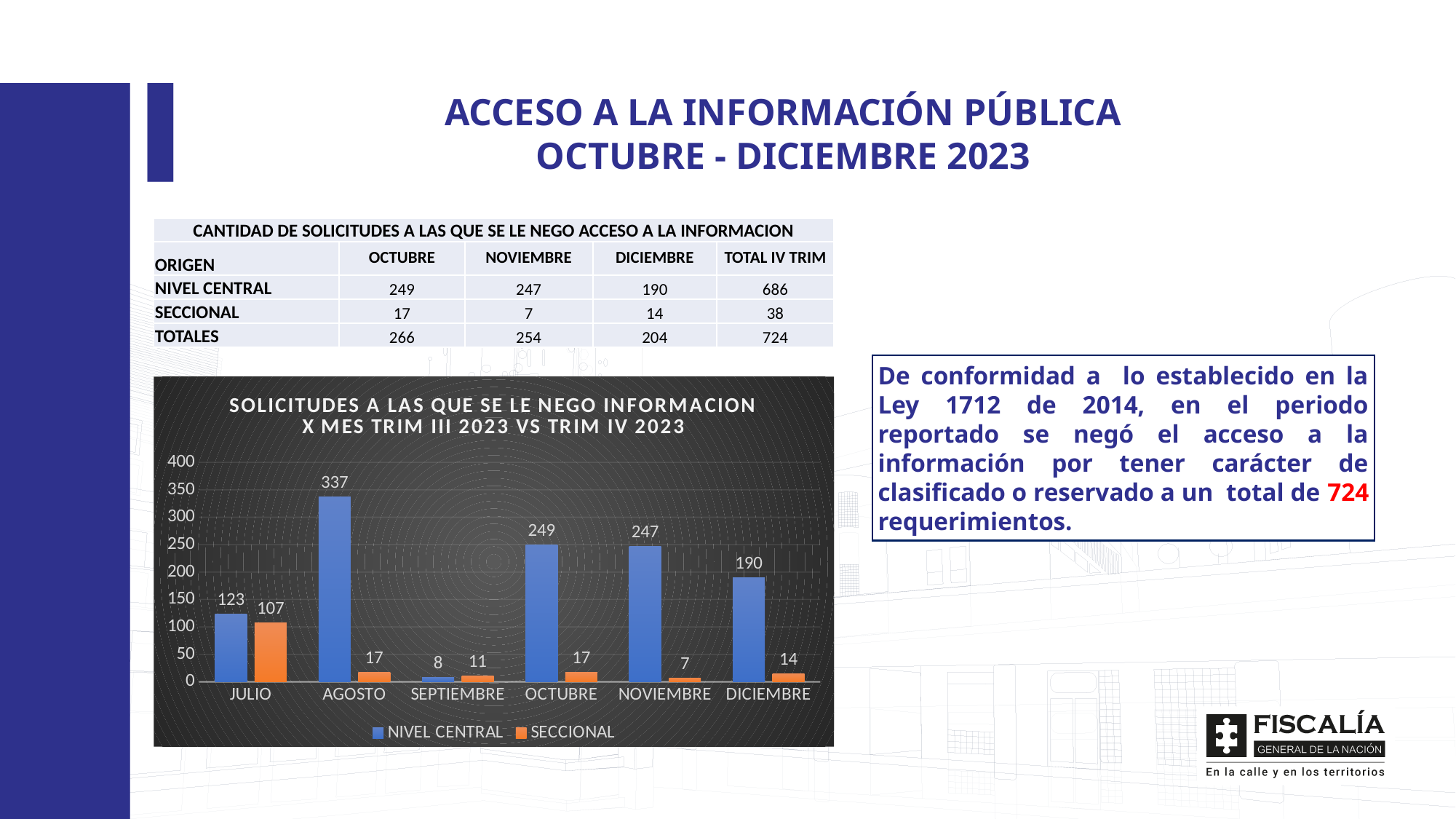
Which colour represents the SECCIONAL series in the chart? Orange What is the difference between the NIVEL CENTRAL values for OCTUBRE and DICIEMBRE? 59 What is the SECCIONAL value for JULIO? 107 How many series does the chart legend list? 2 Which is larger, the SECCIONAL value for SEPTIEMBRE or for DICIEMBRE? DICIEMBRE Which month has the highest NIVEL CENTRAL value? AGOSTO How many months are shown on the x axis of the chart? 6 What is the NIVEL CENTRAL value for AGOSTO? 337 What is the SECCIONAL value for NOVIEMBRE? 7 Which month has the lowest NIVEL CENTRAL value? SEPTIEMBRE What kind of chart is shown on the slide? Bar chart What is the NIVEL CENTRAL value for DICIEMBRE? 190